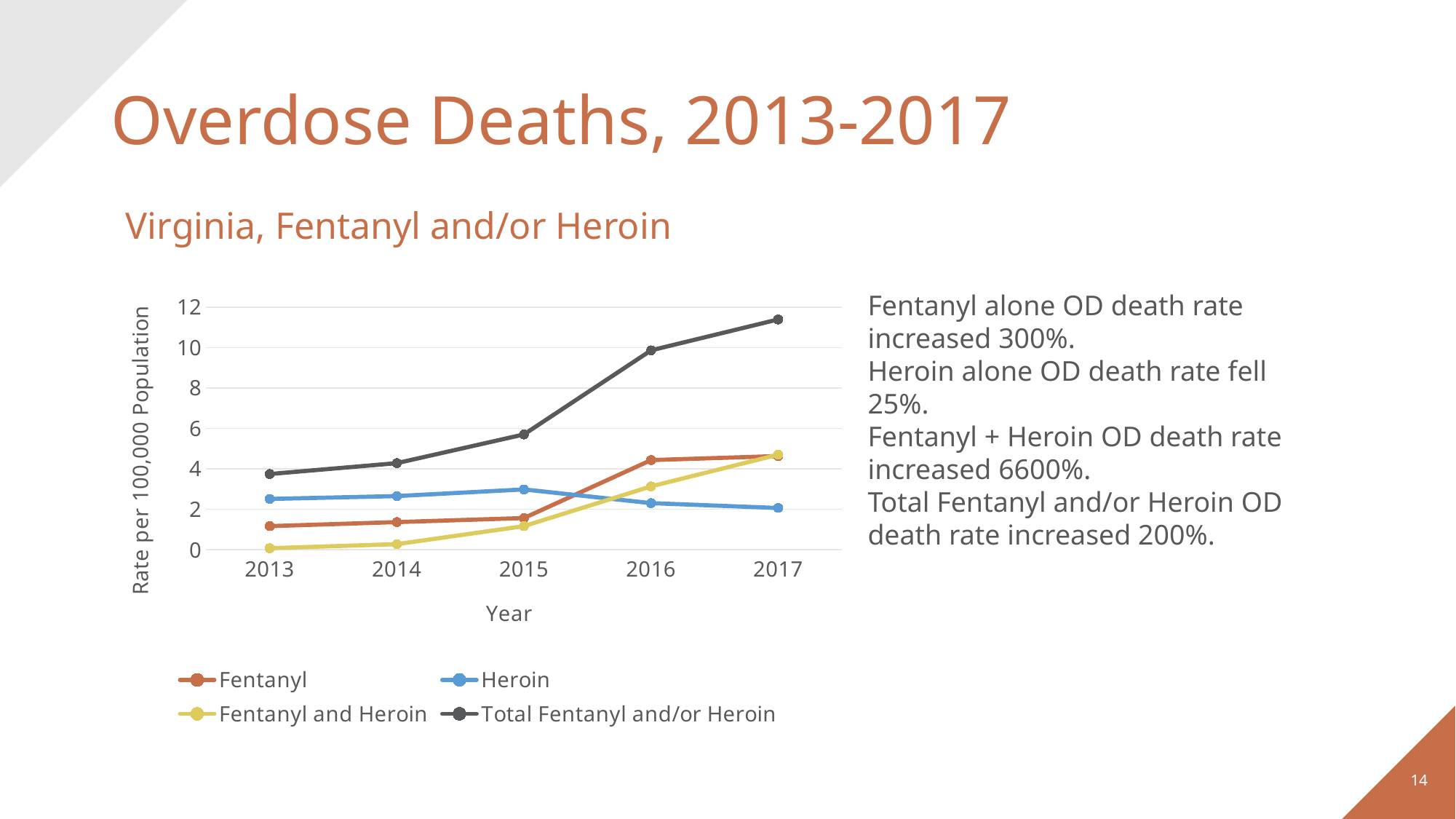
Does the Fentanyl and Heroin line rise or fall from 2013 to 2017? rise Is the value for Fentanyl and Heroin in 2013 greater or less than 2? less In 2013, which is larger: the Fentanyl value or the Heroin value? Heroin Does the Total Fentanyl and/or Heroin line rise or fall from 2013 to 2017? rise What is the label of the y axis? Rate per 100,000 Population What kind of chart is shown on the slide? line chart Is the value for Total Fentanyl and/or Heroin in 2017 greater or less than 10? greater Which series has the lowest value in 2013? Fentanyl and Heroin How many series does the legend list? 4 Which series has the highest value in 2017? Total Fentanyl and/or Heroin In 2016, which is larger: the Fentanyl value or the Heroin value? Fentanyl How many years are plotted along the x axis? 5